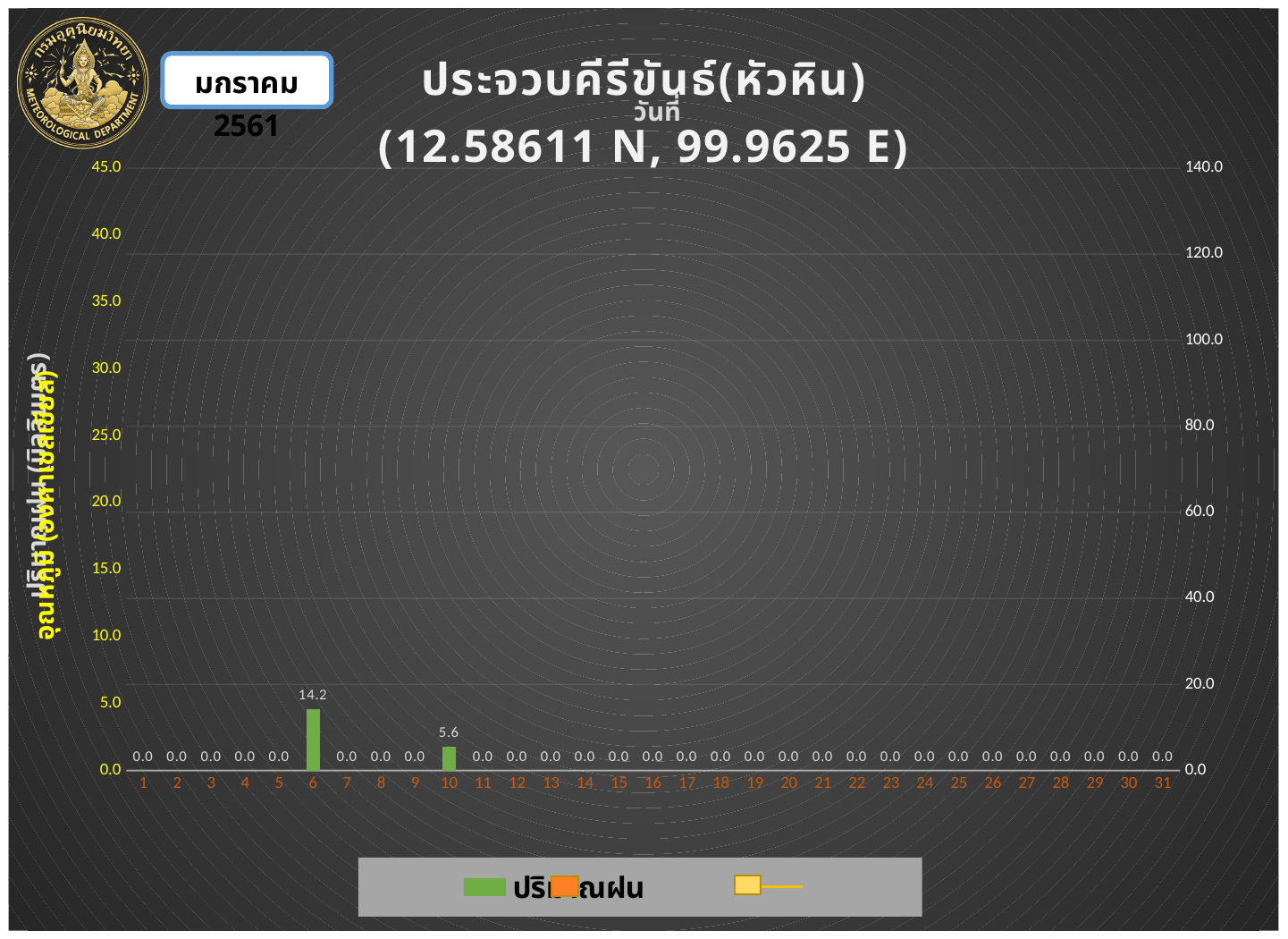
What is the rainfall value shown for day 10? 5.6 What is the difference between the rainfall values for day 6 and day 10? 8.6 Which day has the highest rainfall value? 6 What is the highest tick value on the right vertical axis? 140.0 What is the rainfall value shown for day 6? 14.2 What is the highest tick value on the left vertical axis? 45.0 What kind of chart is shown on the slide? bar chart How many days are shown on the x axis? 31 What is the rainfall value shown for day 1? 0.0 What is the rainfall value shown for day 20? 0.0 Which has a larger rainfall value, day 6 or day 10? day 6 How many days have a non-zero rainfall value? 2